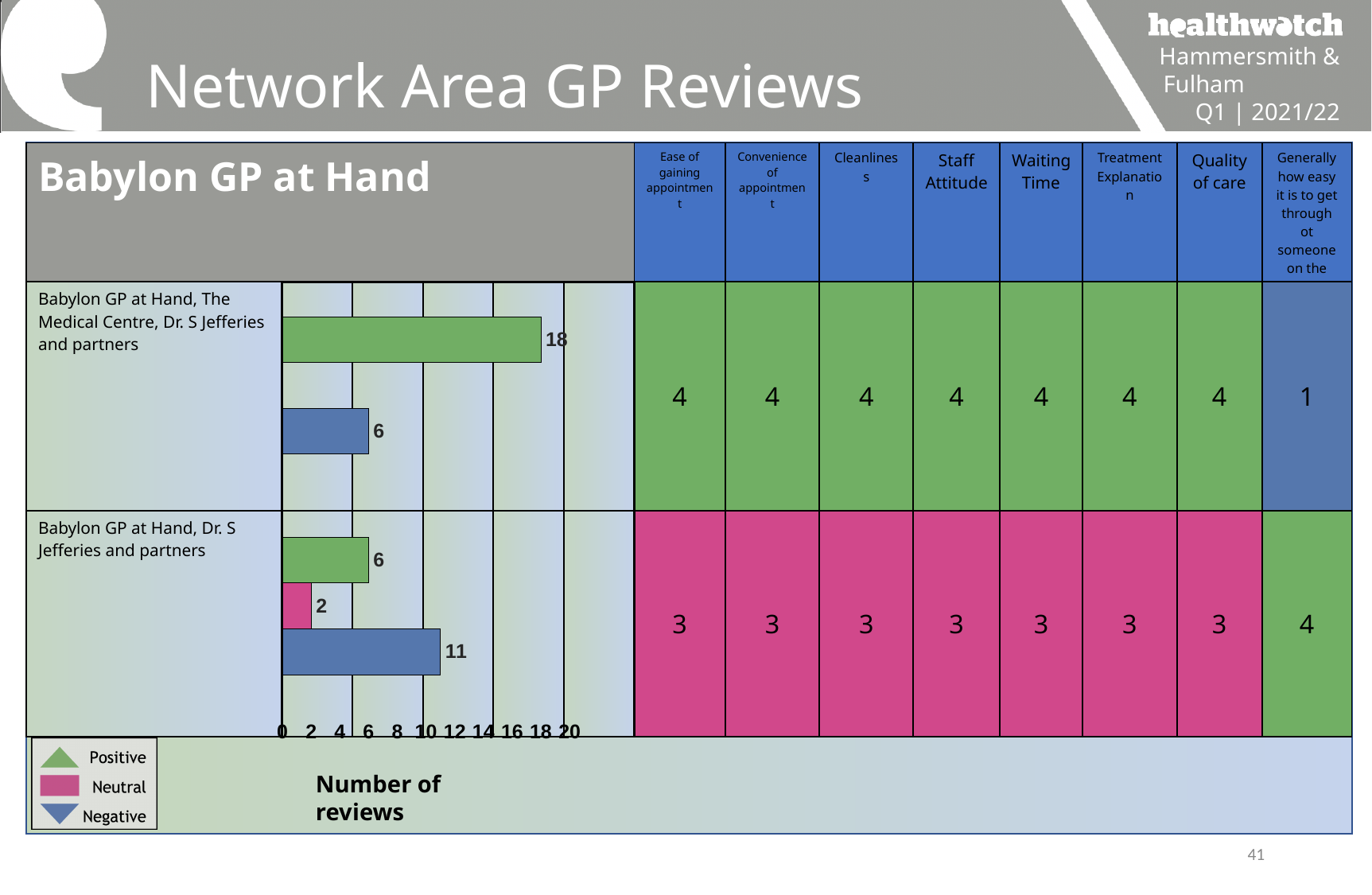
Which bar in the chart has the lowest number of reviews? Neutral reviews for Babylon GP at Hand, Dr. S Jefferies and partners (2) How many series does the legend of the bar chart list? 3 How many positive reviews does the bar chart show for Babylon GP at Hand, The Medical Centre, Dr. S Jefferies and partners? 18 What is the difference between the positive and negative review counts for Babylon GP at Hand, The Medical Centre, Dr. S Jefferies and partners? 12 How many positive reviews does the bar chart show for Babylon GP at Hand, Dr. S Jefferies and partners? 6 What is the total number of reviews shown in the bar chart for Babylon GP at Hand, Dr. S Jefferies and partners? 19 How many negative reviews does the bar chart show for Babylon GP at Hand, Dr. S Jefferies and partners? 11 Which bar in the chart has the highest number of reviews? Positive reviews for Babylon GP at Hand, The Medical Centre, Dr. S Jefferies and partners (18) For Babylon GP at Hand, Dr. S Jefferies and partners, which is larger: the number of positive reviews or the number of negative reviews? Negative reviews What type of chart is used to show the number of reviews? Bar chart How many neutral reviews does the bar chart show for Babylon GP at Hand, Dr. S Jefferies and partners? 2 How many negative reviews does the bar chart show for Babylon GP at Hand, The Medical Centre, Dr. S Jefferies and partners? 6